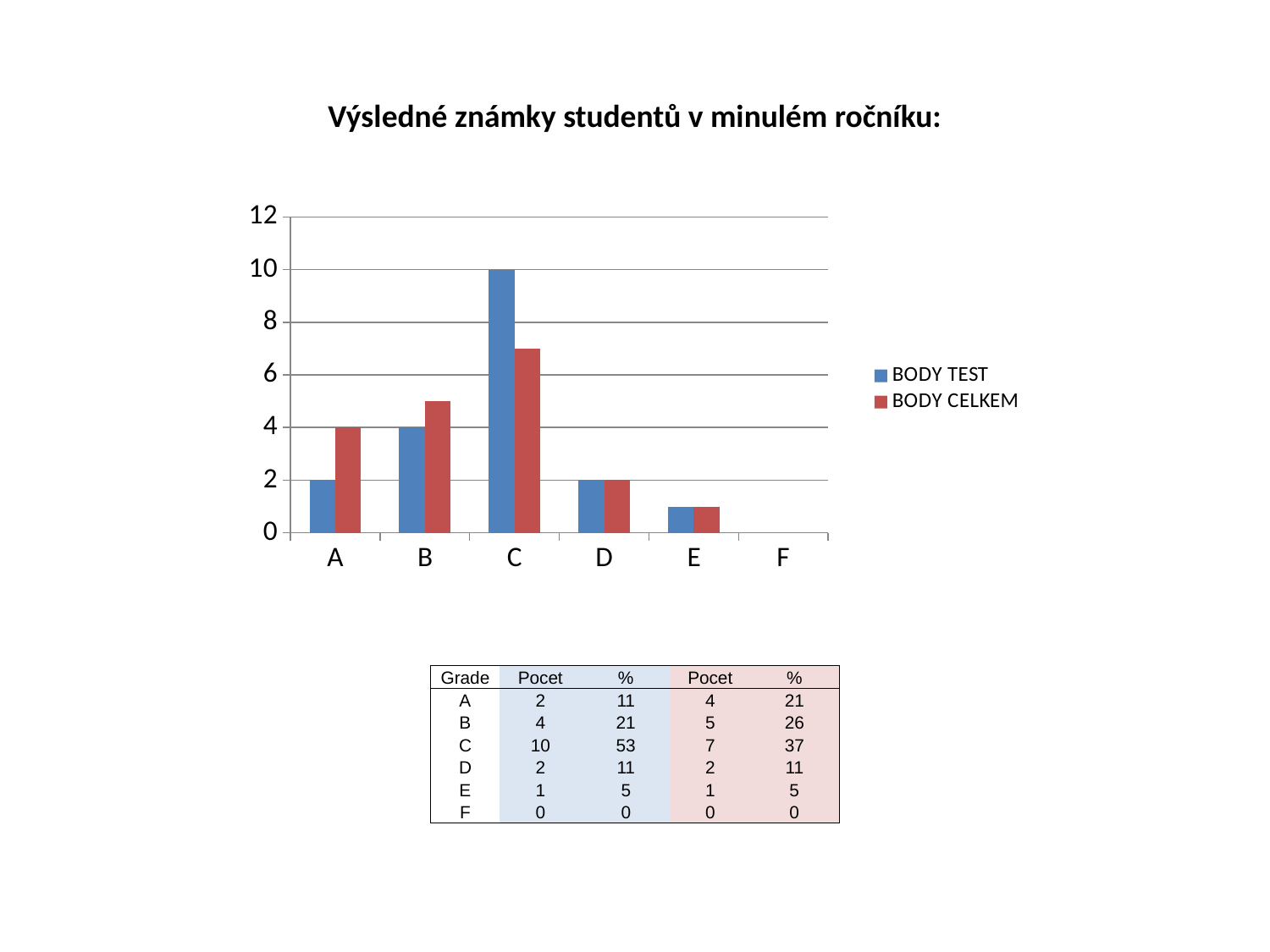
Is the BODY CELKEM value for grade C greater or less than 6? greater What kind of chart is shown on the slide? bar chart How many series does the legend list? 2 What is the BODY CELKEM value for grade B? 5 Which grade has the highest BODY TEST value? C Which grade has the lowest BODY CELKEM value? F What is the difference between the BODY TEST and BODY CELKEM values for grade C? 3 For grade A, which is larger: BODY TEST or BODY CELKEM? BODY CELKEM How many grade categories are shown on the x axis? 6 What is the title of the chart? Výsledné známky studentů v minulém ročníku: What is the BODY TEST value for grade C? 10 What is the BODY TEST value for grade A? 2